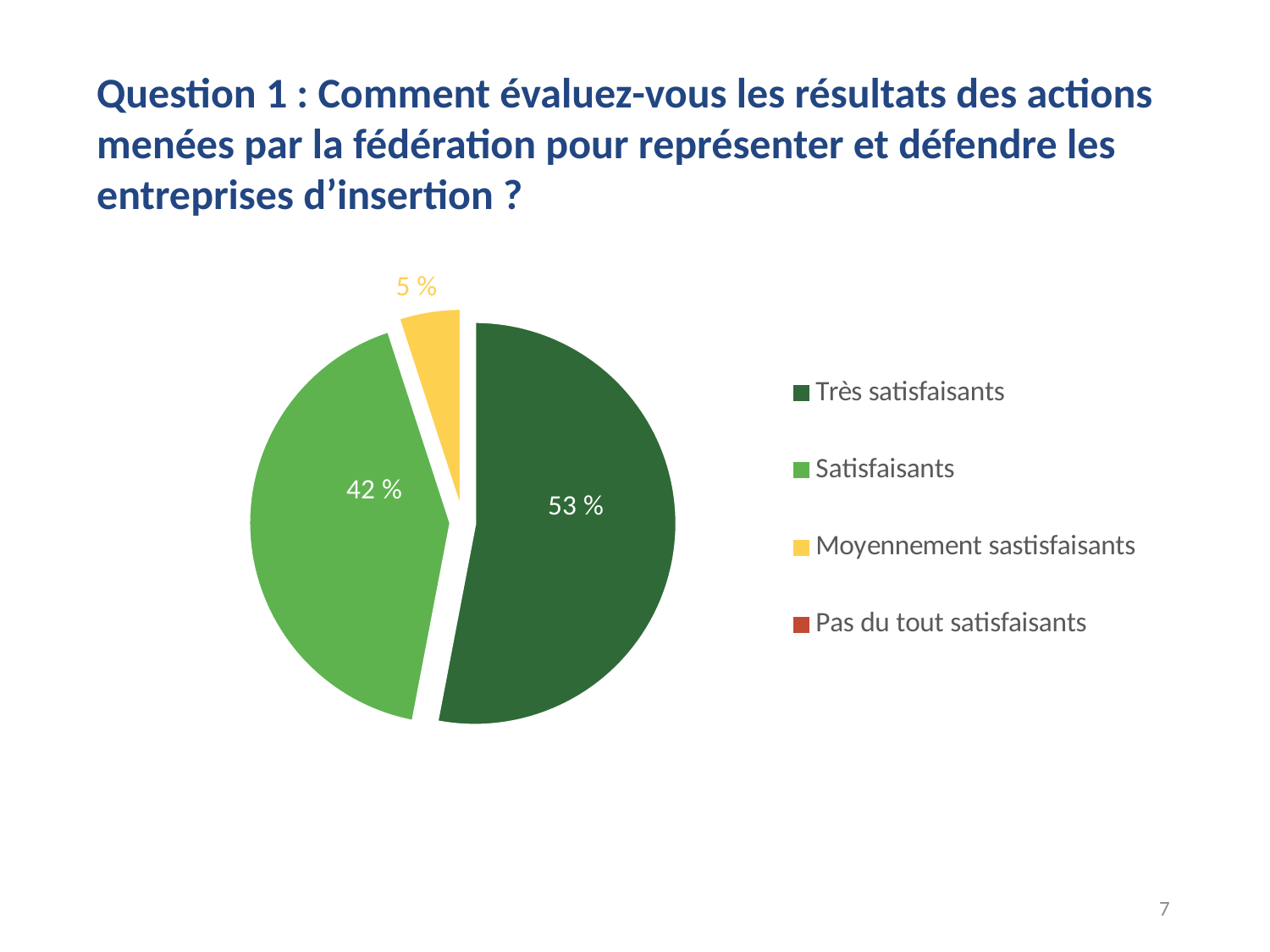
What share of the pie is labelled "Satisfaisants"? 42 % Which category has the largest slice of the pie? Très satisfaisants Which slice is larger: "Satisfaisants" or "Moyennement sastisfaisants"? Satisfaisants What share of the pie is labelled "Moyennement sastisfaisants"? 5 % How many slices with data labels are shown in the pie? 3 What kind of chart is shown on the slide? Pie chart What colour is the "Moyennement sastisfaisants" slice? Yellow Which category with a visible slice has the smallest share of the pie? Moyennement sastisfaisants How many entries does the legend list? 4 Which legend entry has no visible slice in the pie? Pas du tout satisfaisants What is the difference in percentage points between the "Très satisfaisants" and "Satisfaisants" slices? 11 What share of the pie is labelled "Très satisfaisants"? 53 %